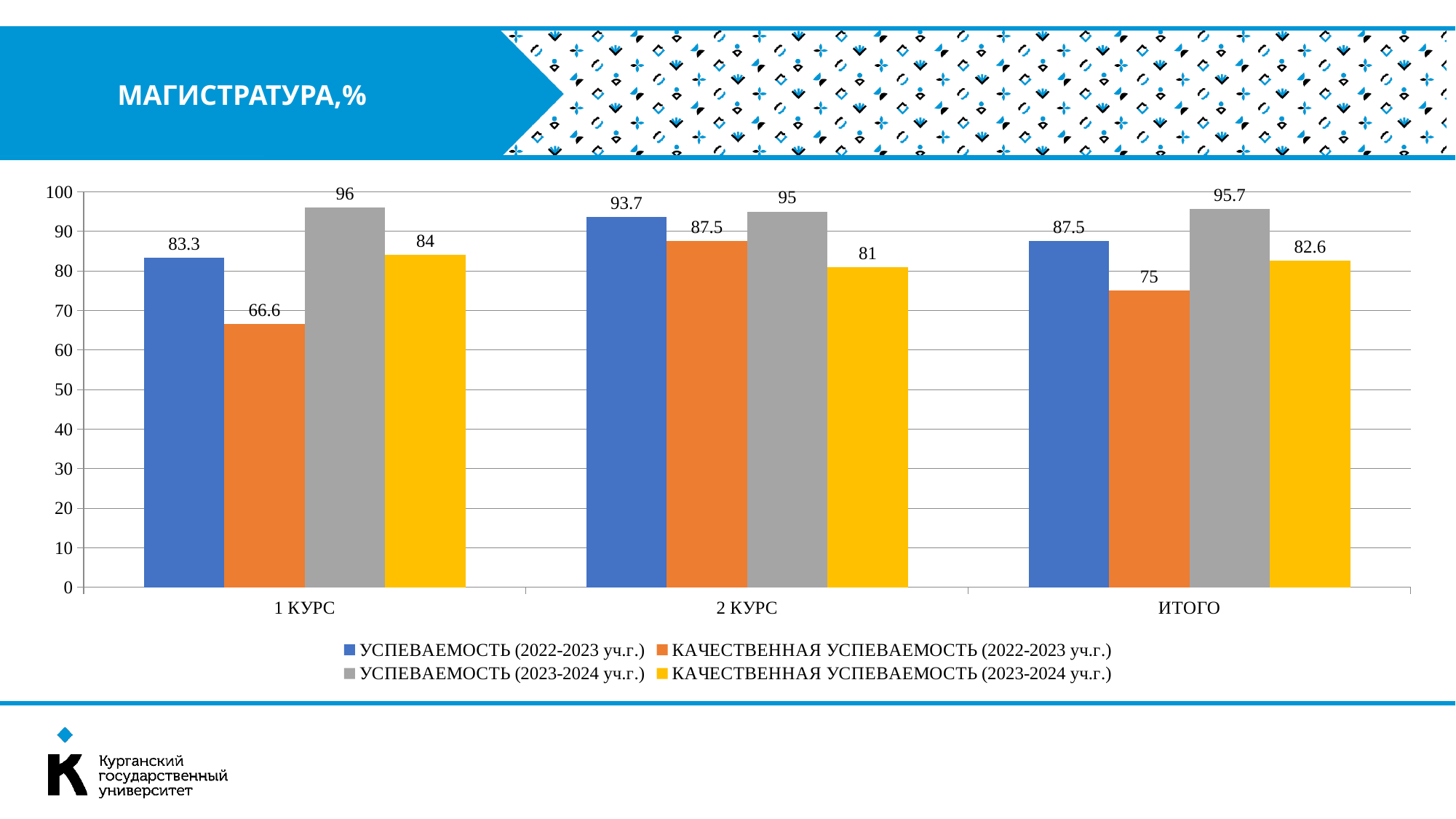
Which category has the lowest value for КАЧЕСТВЕННАЯ УСПЕВАЕМОСТЬ (2022-2023 уч.г.)? 1 КУРС Is the value of КАЧЕСТВЕННАЯ УСПЕВАЕМОСТЬ (2022-2023 уч.г.) for 1 КУРС greater or less than 70? less Which category has the highest value for УСПЕВАЕМОСТЬ (2023-2024 уч.г.)? 1 КУРС What is the value of УСПЕВАЕМОСТЬ (2022-2023 уч.г.) for 1 КУРС? 83.3 What kind of chart is shown on the slide? bar chart What is the difference between УСПЕВАЕМОСТЬ (2023-2024 уч.г.) and УСПЕВАЕМОСТЬ (2022-2023 уч.г.) for 1 КУРС? 12.7 How many series does the legend list? 4 What is the value of УСПЕВАЕМОСТЬ (2023-2024 уч.г.) for ИТОГО? 95.7 What is the value of КАЧЕСТВЕННАЯ УСПЕВАЕМОСТЬ (2022-2023 уч.г.) for ИТОГО? 75 What is the value of КАЧЕСТВЕННАЯ УСПЕВАЕМОСТЬ (2023-2024 уч.г.) for 2 КУРС? 81 How many categories are shown on the x axis? 3 Which is larger for 2 КУРС: КАЧЕСТВЕННАЯ УСПЕВАЕМОСТЬ (2022-2023 уч.г.) or КАЧЕСТВЕННАЯ УСПЕВАЕМОСТЬ (2023-2024 уч.г.)? КАЧЕСТВЕННАЯ УСПЕВАЕМОСТЬ (2022-2023 уч.г.)